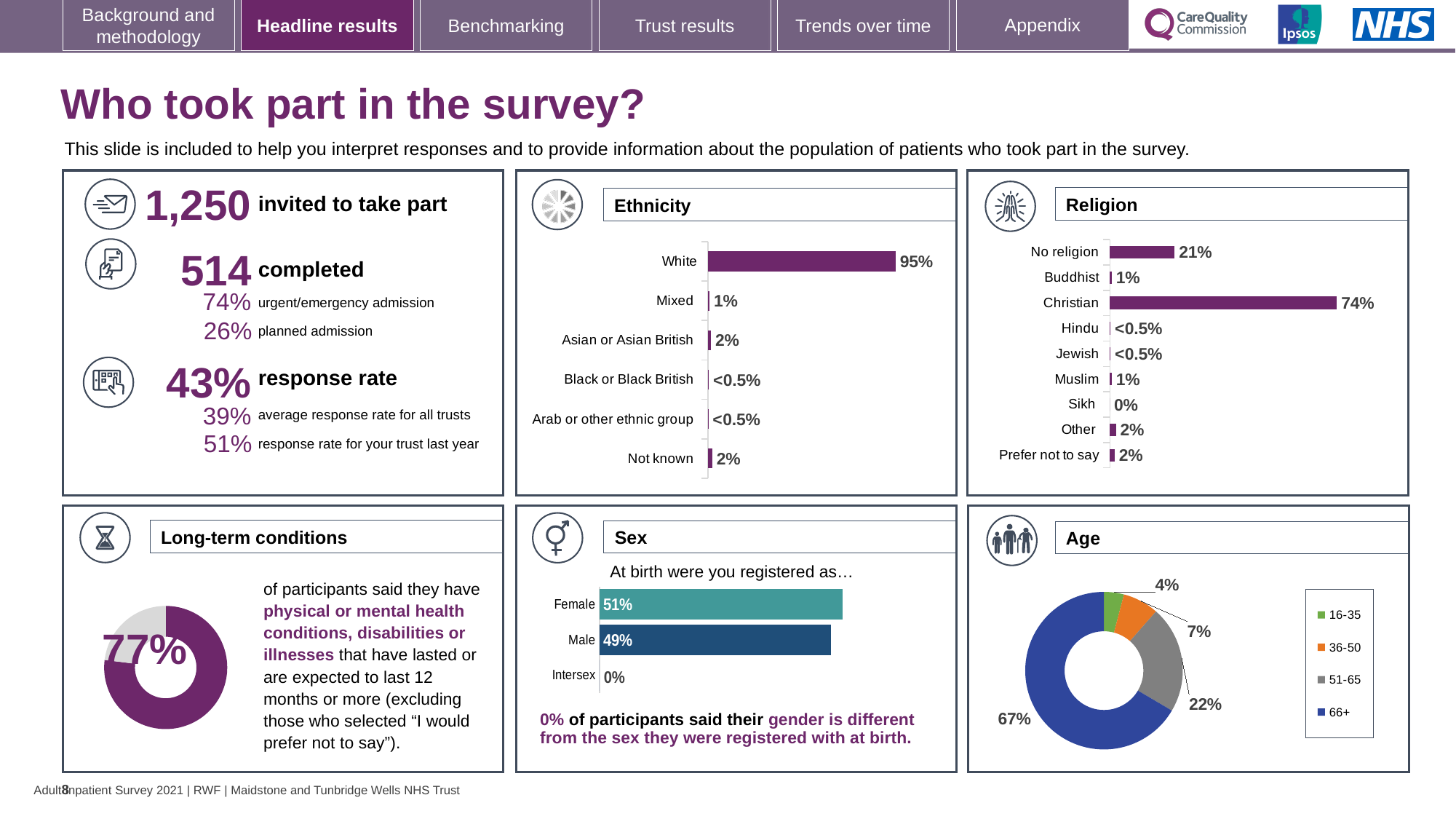
What kind of chart is used in the Age panel? Doughnut chart In the Religion chart, which category has the lowest value? Sikh In the Ethnicity chart, which ethnic group has the highest value? White How many categories are shown in the Ethnicity chart? 6 How many series does the legend of the Age chart list? 4 In the Sex chart, what percentage of participants were registered as Female at birth? 51% In the Religion chart, what is the difference between the Christian and No religion values? 53% In the Age chart, what share of participants were aged 66+? 67% In the Ethnicity chart, what percentage of participants were White? 95% In the Sex chart, which is larger, the Female value or the Male value? Female In the Religion chart, what percentage of participants were Christian? 74% How many categories are shown in the Religion chart? 9